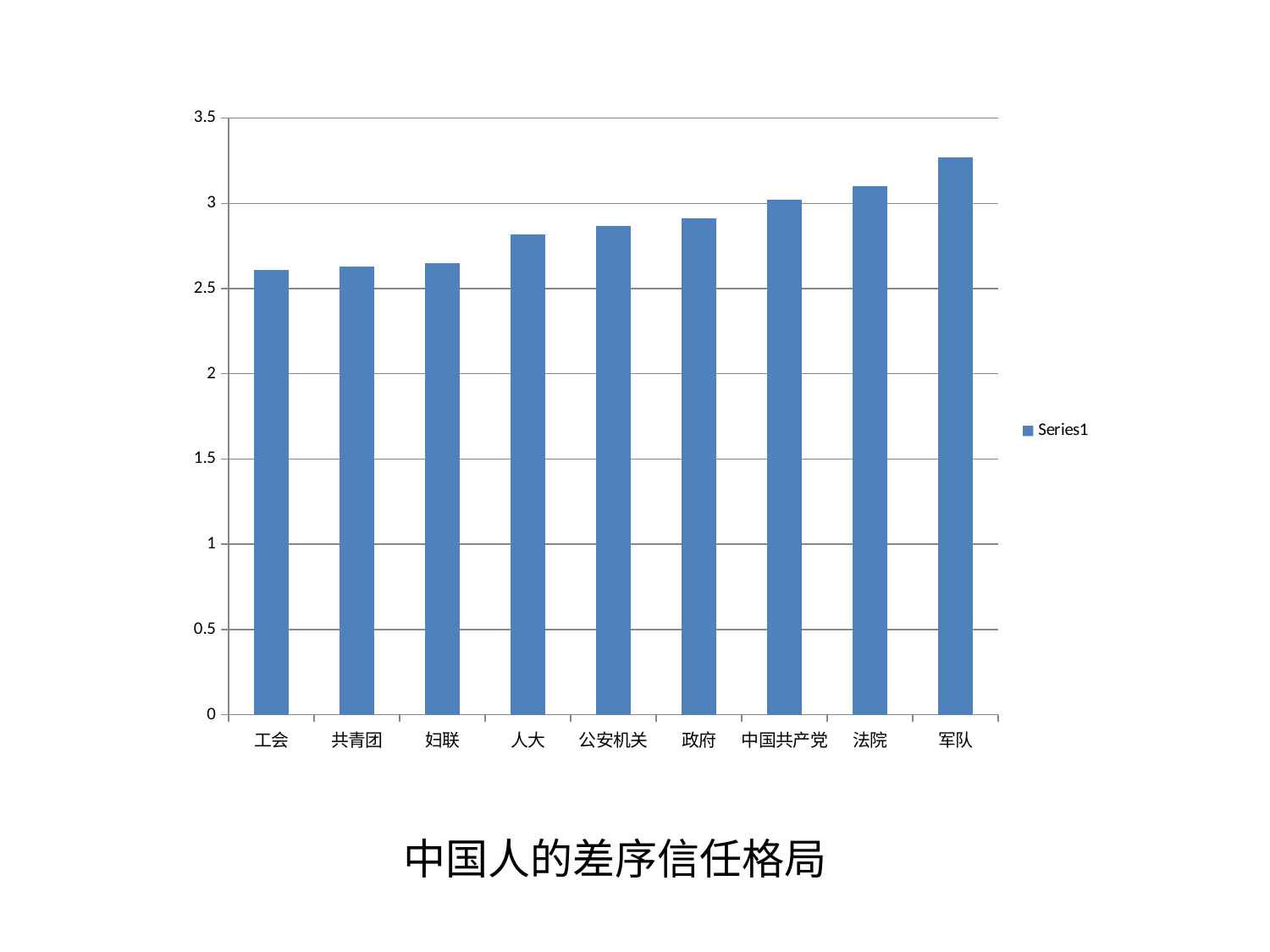
Do the values rise or fall moving from left to right along the x axis? rise How many series does the legend list? 1 Is the value for 工会 greater or less than 3? less Is the value for 公安机关 greater or less than 3? less Is the value for 军队 greater or less than 3? greater How many categories are shown on the x axis of the chart? 9 What kind of chart is shown on the slide? bar chart Which has a larger value, 妇联 or 政府? 政府 Which category has the highest value in the chart? 军队 Which has a larger value, 法院 or 人大? 法院 What is the name of the series shown in the legend? Series1